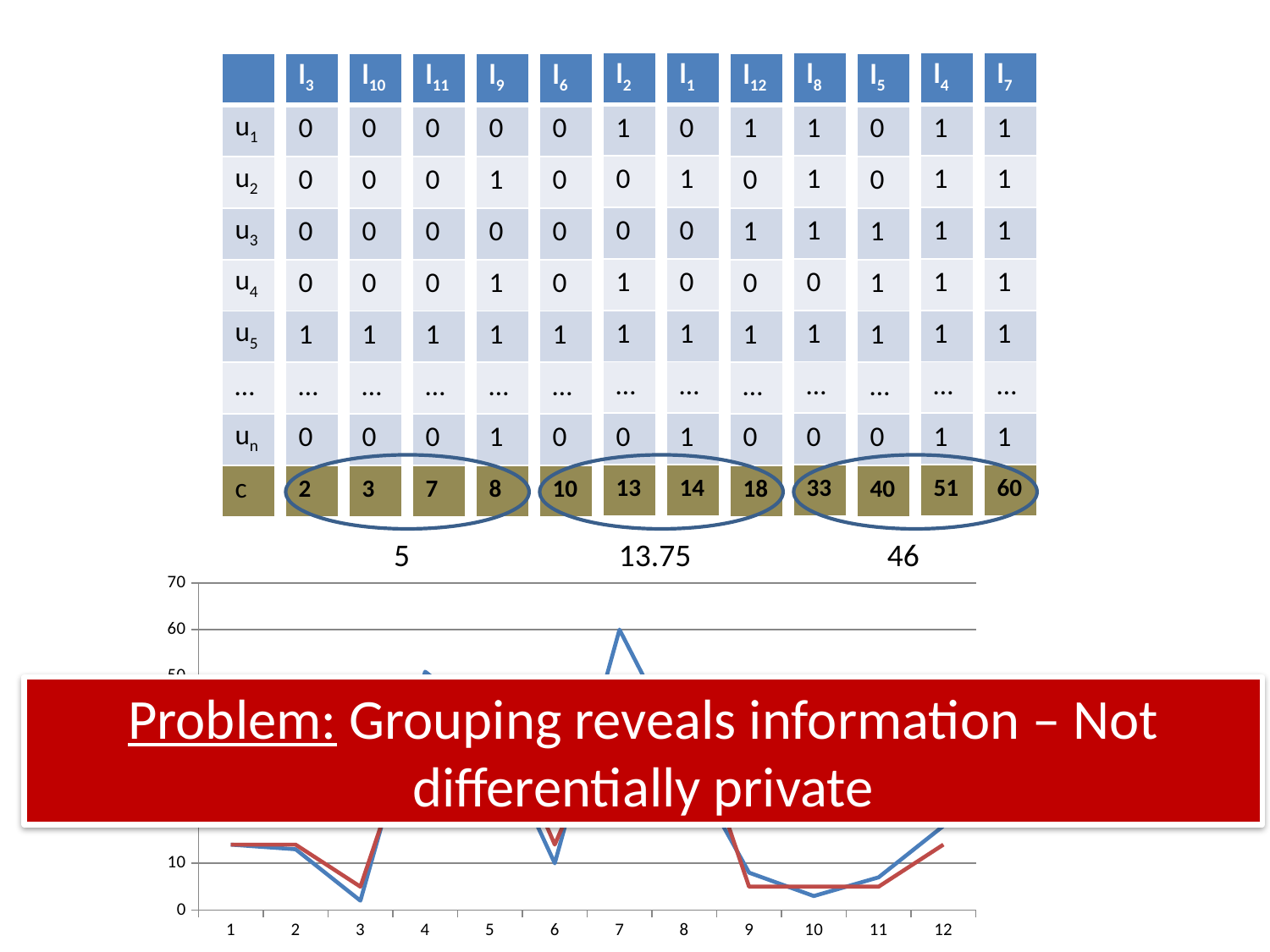
Is the value of the blue line at x = 7 greater or less than 50? greater Which line has the higher value at x = 7, the blue line or the red line? blue line Is the value of the red line at x = 12 greater or less than 10? greater What kind of chart is shown at the bottom of the slide? line chart Which line has the higher value at x = 3, the blue line or the red line? red line Is the value of the blue line at x = 3 greater or less than 10? less How many lines are plotted in the line chart? 2 What is the highest value shown on the y axis of the line chart? 70 How many points are labelled along the x axis of the line chart? 12